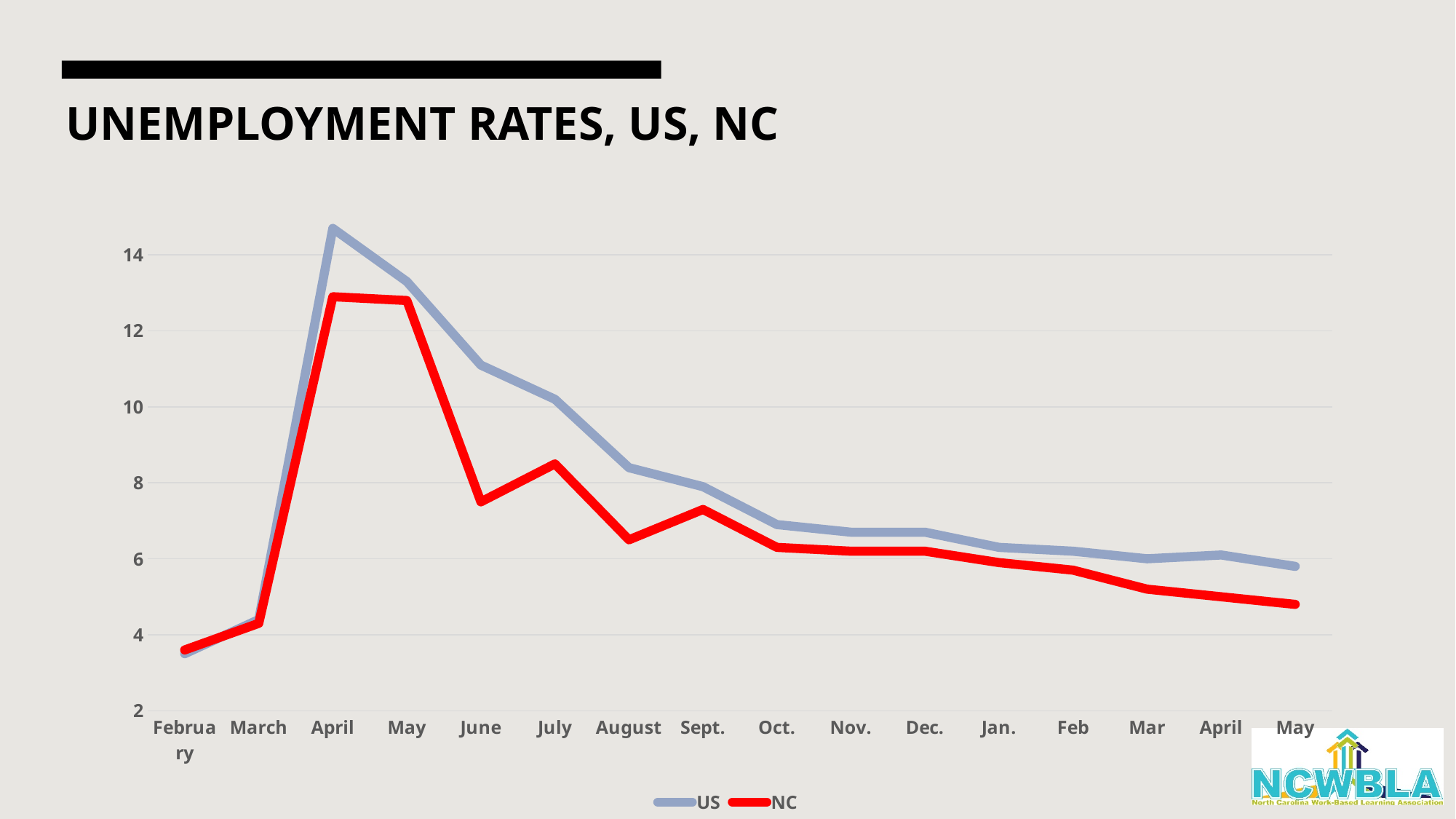
Is the NC value for the first April greater or less than 14? less Is the US value for the first April greater or less than 14? greater In which month does the US unemployment rate reach its highest point? April Is the NC value for the final May greater or less than 6? less How many series does the legend list? 2 In July, which series has the higher unemployment rate, US or NC? US In which month is the NC unemployment rate at its lowest? February What colour is the NC line in the chart? red What kind of chart is shown on the slide? line chart From the first April to the final May, does the US unemployment rate rise or fall overall? fall How many months are plotted along the x axis? 16